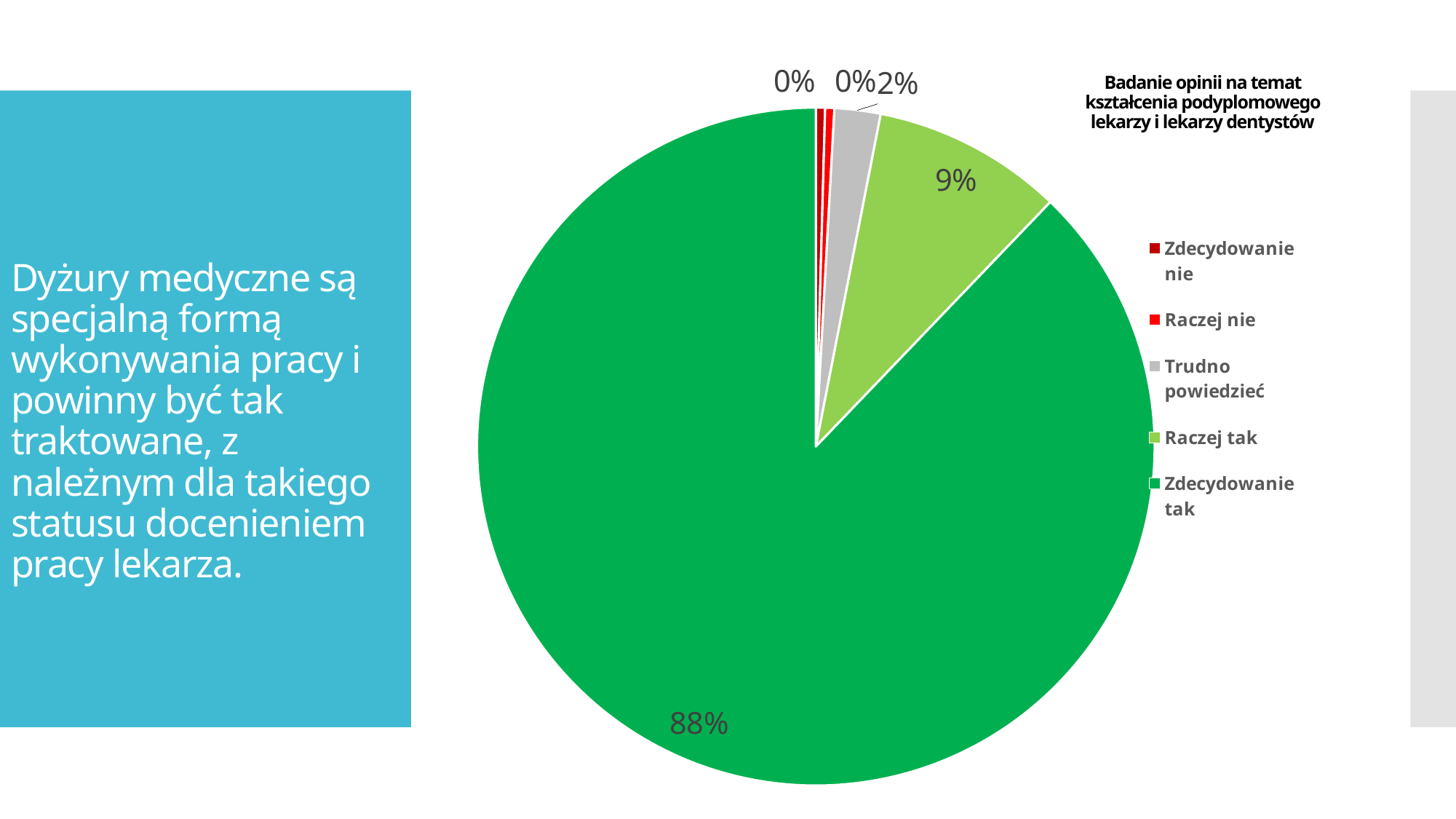
What percentage of the pie is labelled for "Zdecydowanie tak"? 88% What is the difference in percentage points between "Zdecydowanie tak" and "Raczej tak"? 79 What percentage of the pie is labelled for "Raczej nie"? 0% What is the title of the chart? Badanie opinii na temat kształcenia podyplomowego lekarzy i lekarzy dentystów What colour is the "Trudno powiedzieć" slice? grey Which slice is larger, "Raczej tak" or "Trudno powiedzieć"? Raczej tak What percentage of the pie is labelled for "Raczej tak"? 9% What is the combined share of "Zdecydowanie tak" and "Raczej tak"? 97% How many categories does the legend list? 5 Which category has the largest slice of the pie? Zdecydowanie tak What type of chart is shown on the slide? pie chart What percentage of the pie is labelled for "Trudno powiedzieć"? 2%